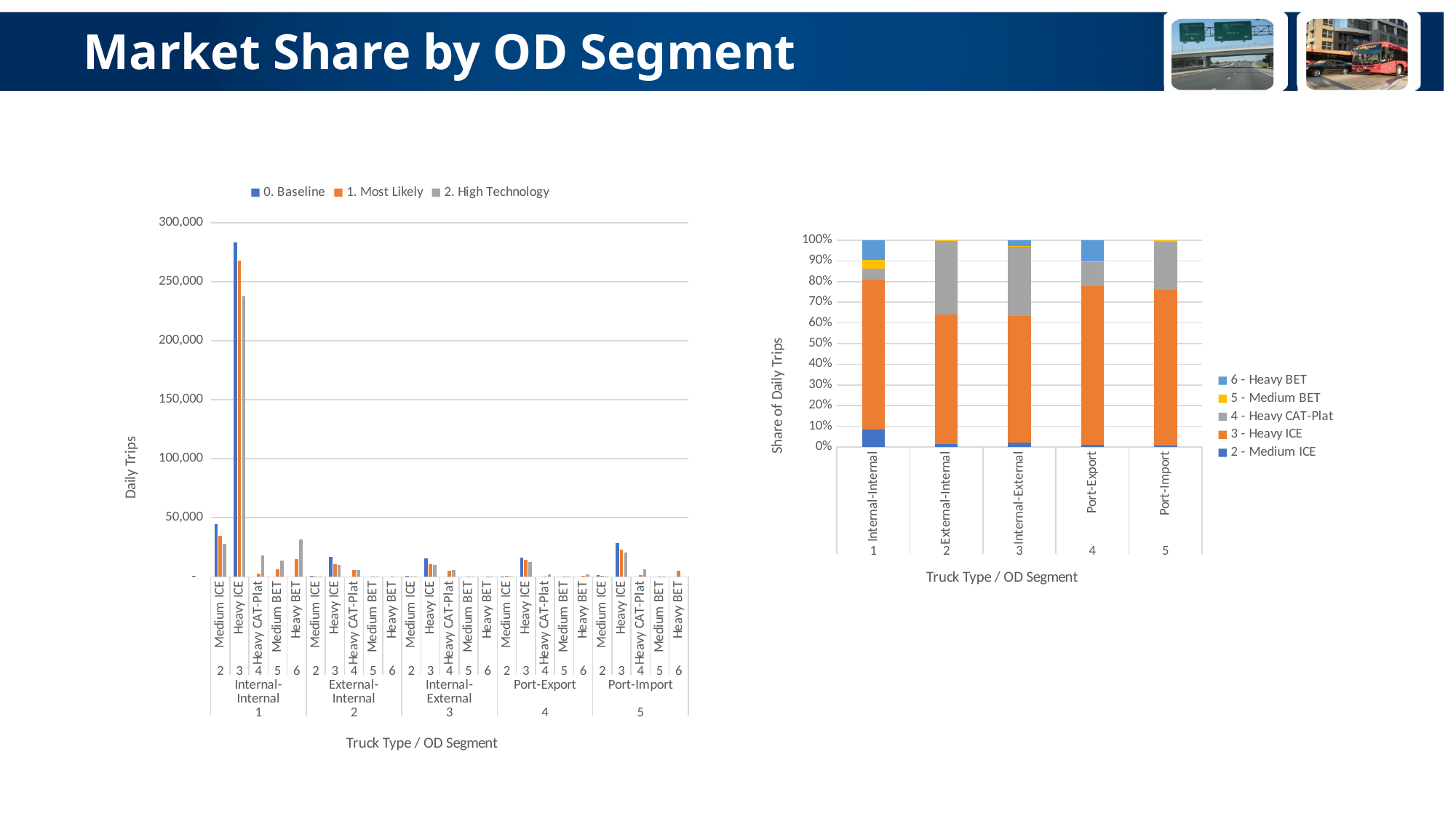
In the left chart (Daily Trips), for Heavy BET in the Internal-Internal segment, which is larger: 0. Baseline or 2. High Technology? 2. High Technology How many series does the legend of the right chart (Share of Daily Trips) list? 5 In the left chart (Daily Trips), for Heavy ICE in the Internal-Internal segment, which is larger: 0. Baseline or 1. Most Likely? 0. Baseline In the right chart (Share of Daily Trips), which OD segment has the largest share for 3 - Heavy ICE? Port-Export In the right chart (Share of Daily Trips), is the share of 3 - Heavy ICE in the Internal-Internal segment greater or less than 70%? greater What kind of chart is the chart on the left of the slide? bar chart In the left chart (Daily Trips), which truck type and OD segment has the highest bar? Heavy ICE, Internal-Internal How many OD segments are shown on the x axis of the right chart (Share of Daily Trips)? 5 In the left chart (Daily Trips), is the 0. Baseline value for Heavy ICE in the Internal-Internal segment greater or less than 250,000? greater In the right chart (Share of Daily Trips), which segment has the larger share for 4 - Heavy CAT-Plat: Internal-Internal or External-Internal? External-Internal In the left chart (Daily Trips), is the 2. High Technology value for Heavy ICE in the Internal-Internal segment greater or less than 250,000? less How many series does the legend of the left chart (Daily Trips) list? 3